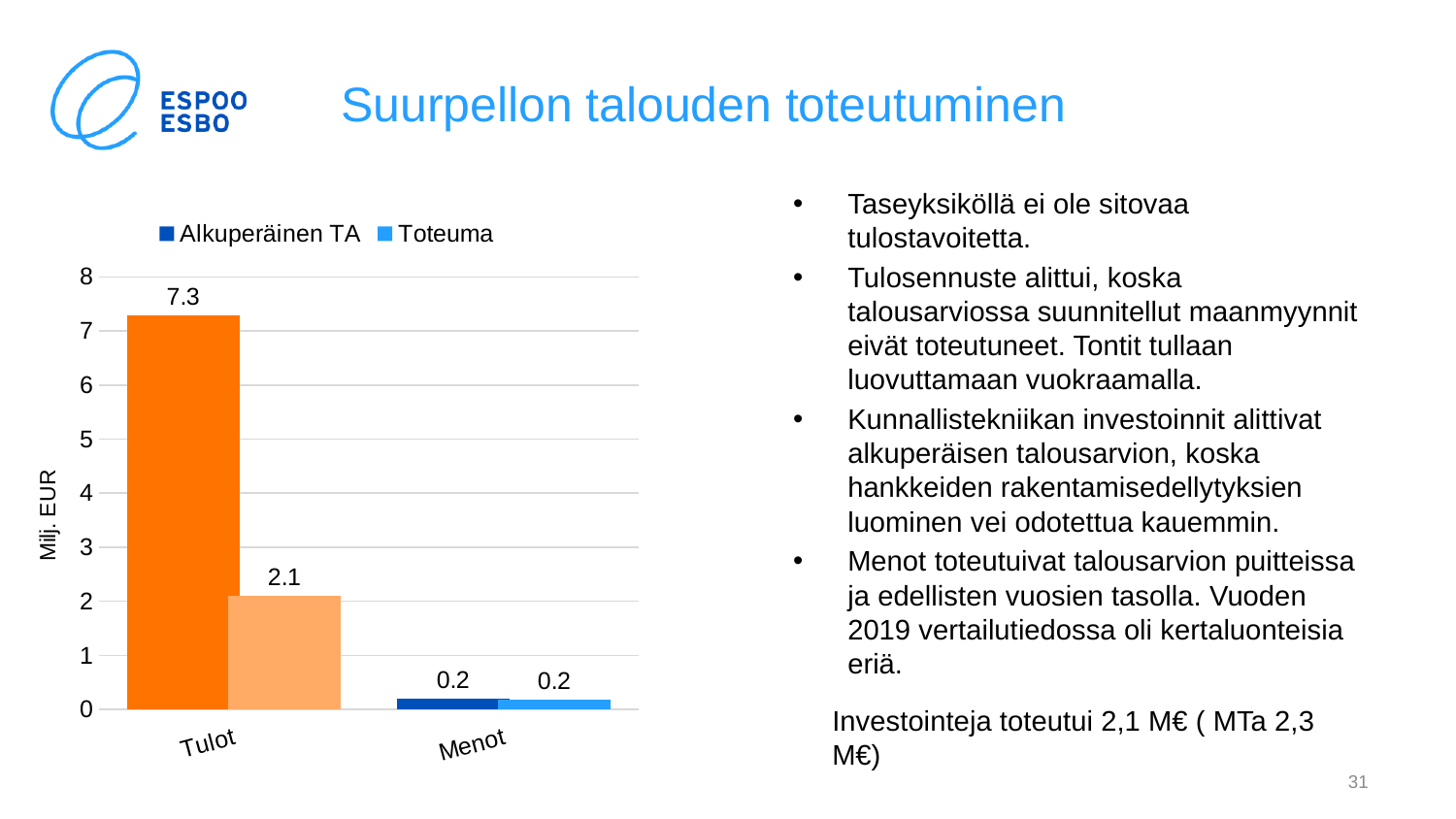
What kind of chart is shown on the slide? Bar chart How many categories are shown on the x axis? 2 What is the label of the y axis? Milj. EUR Which category has the lowest Toteuma value? Menot What is the difference between the Alkuperäinen TA and Toteuma values for Tulot? 5.2 What is the Toteuma value for Menot? 0.2 For Tulot, which is larger: Alkuperäinen TA or Toteuma? Alkuperäinen TA What is the Alkuperäinen TA value for Tulot? 7.3 What is the Toteuma value for Tulot? 2.1 How many series does the legend list? 2 What is the Alkuperäinen TA value for Menot? 0.2 Which category has the highest Alkuperäinen TA value? Tulot